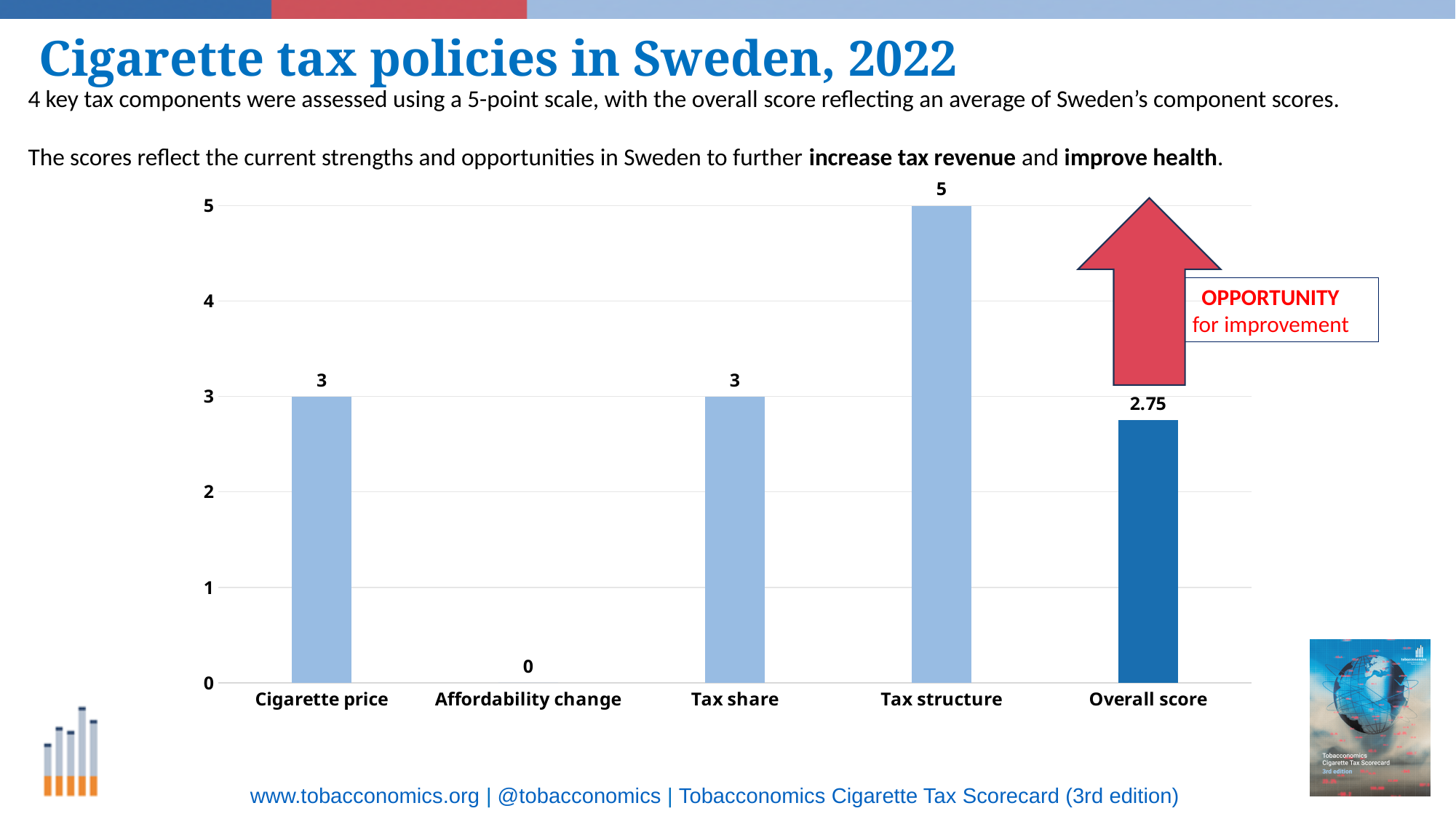
What is the difference between the Tax structure score and the Tax share score? 2 What is the score for Tax structure? 5 Which category has the lowest score? Affordability change How many categories are shown on the x axis? 5 Which category has the highest score? Tax structure What is the difference between the Tax structure score and the Overall score? 2.25 What is the score for Affordability change? 0 What text appears in the box next to the red arrow? OPPORTUNITY for improvement What kind of chart is shown on the slide? Bar chart Which is larger, the Cigarette price score or the Overall score? Cigarette price What is the Overall score? 2.75 What is the score for Cigarette price? 3